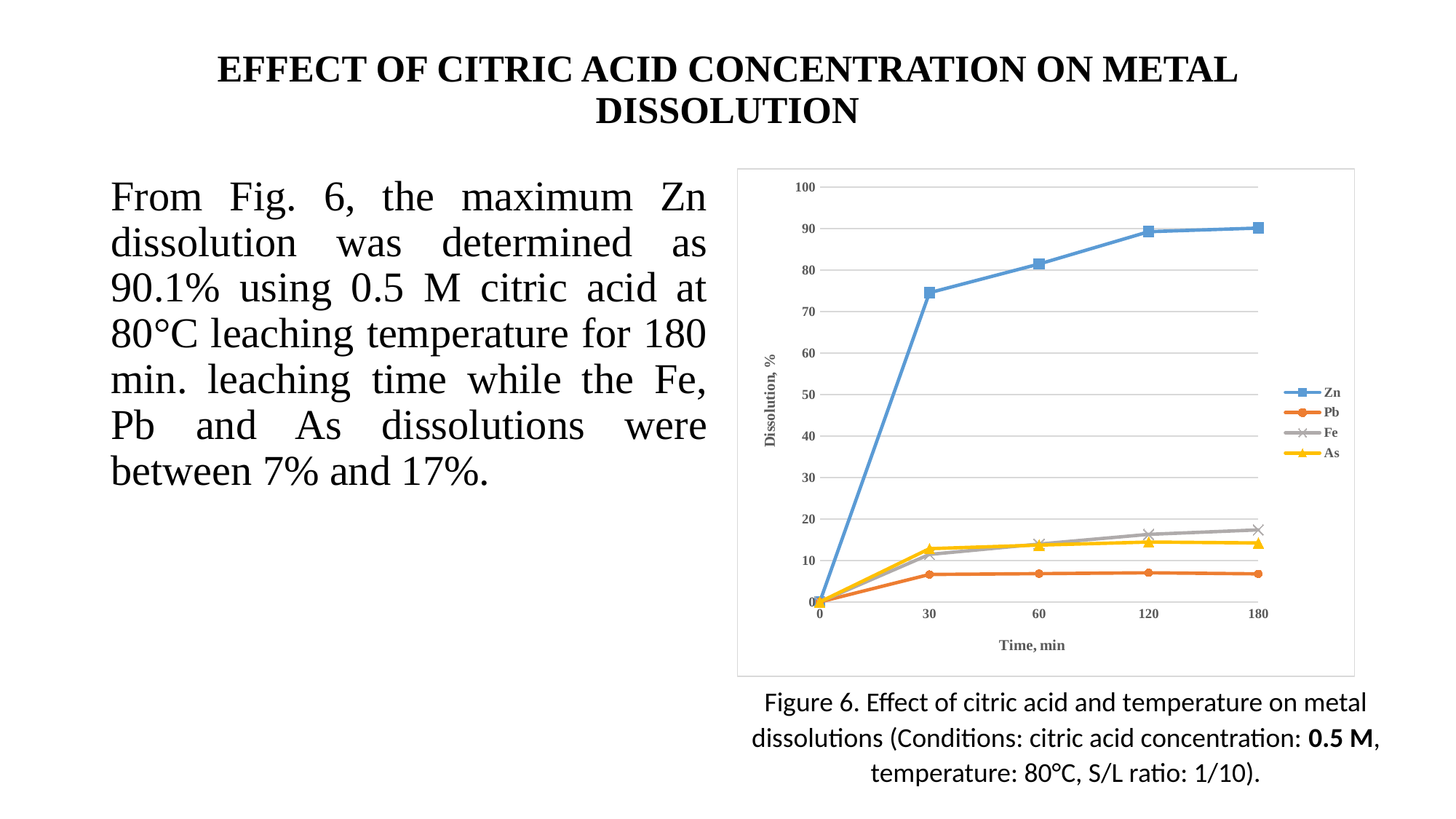
How many time points are plotted along the x axis? 5 Is the Fe dissolution at 180 min greater or less than 20? less What kind of chart is shown on the slide? line chart Does the Zn dissolution rise or fall as time increases from 0 to 180 min? rise What is the title of the y axis of the chart? Dissolution, % At 60 min, which series has the larger dissolution, Zn or Pb? Zn Which series has the highest dissolution at 180 min? Zn How many series does the chart legend list? 4 Which series has the lowest dissolution at 180 min? Pb Is the Zn dissolution at 30 min greater or less than 70? greater Is the Pb dissolution at 180 min greater or less than 10? less